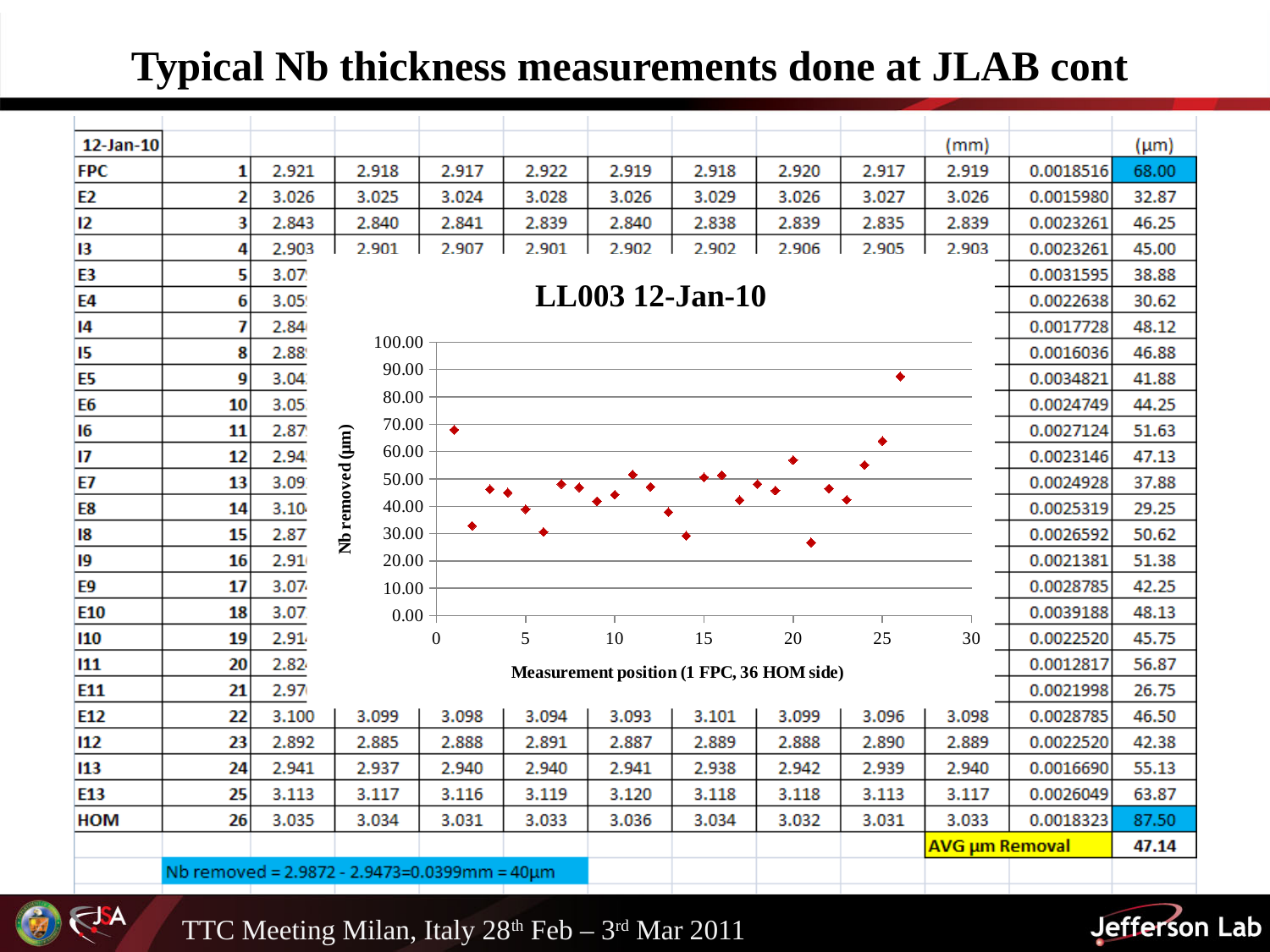
Is the value at measurement position 2 greater or less than 40? less Is the value at measurement position 26 greater or less than 80? greater What is the label of the chart's vertical axis? Nb removed (µm) Which has the larger Nb removed value, measurement position 1 or measurement position 2? measurement position 1 Is the value at measurement position 1 greater or less than 60? greater At which measurement position is the plotted Nb removed value highest? 26 At which measurement position is the plotted Nb removed value lowest? 21 Which has the larger Nb removed value, measurement position 26 or measurement position 1? measurement position 26 What kind of chart is shown on the slide? scatter chart How many data points are plotted in the chart? 26 What is the title of the chart? LL003 12-Jan-10